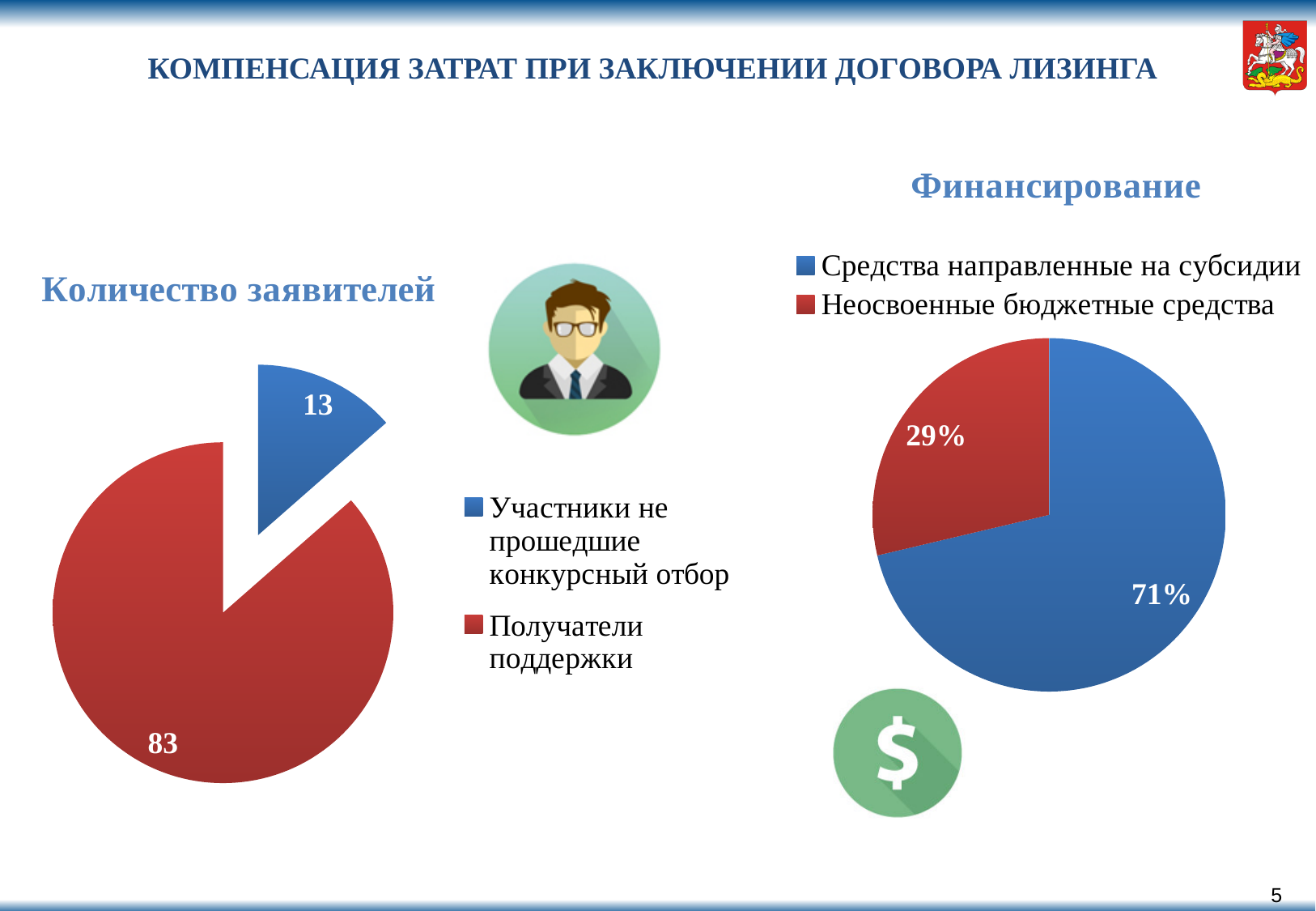
What type of chart is the 'Финансирование' chart? Pie chart In the 'Финансирование' chart, what share is labelled for 'Неосвоенные бюджетные средства'? 29% In the 'Финансирование' chart, which category has the smallest share? Неосвоенные бюджетные средства In the 'Количество заявителей' chart, what is the difference between 'Получатели поддержки' and 'Участники не прошедшие конкурсный отбор'? 70 In the 'Количество заявителей' chart, what is the total of the two slices? 96 In the 'Финансирование' chart, what share is labelled for 'Средства направленные на субсидии'? 71% In the 'Финансирование' chart, what colour is the 'Неосвоенные бюджетные средства' slice? Red In the 'Количество заявителей' chart, which category has the largest value? Получатели поддержки In the 'Финансирование' chart, which is larger: 'Средства направленные на субсидии' or 'Неосвоенные бюджетные средства'? Средства направленные на субсидии In the 'Количество заявителей' chart, how many slices does the pie have? 2 In the 'Количество заявителей' chart, what is the value for 'Участники не прошедшие конкурсный отбор'? 13 In the 'Количество заявителей' chart, what is the value for 'Получатели поддержки'? 83